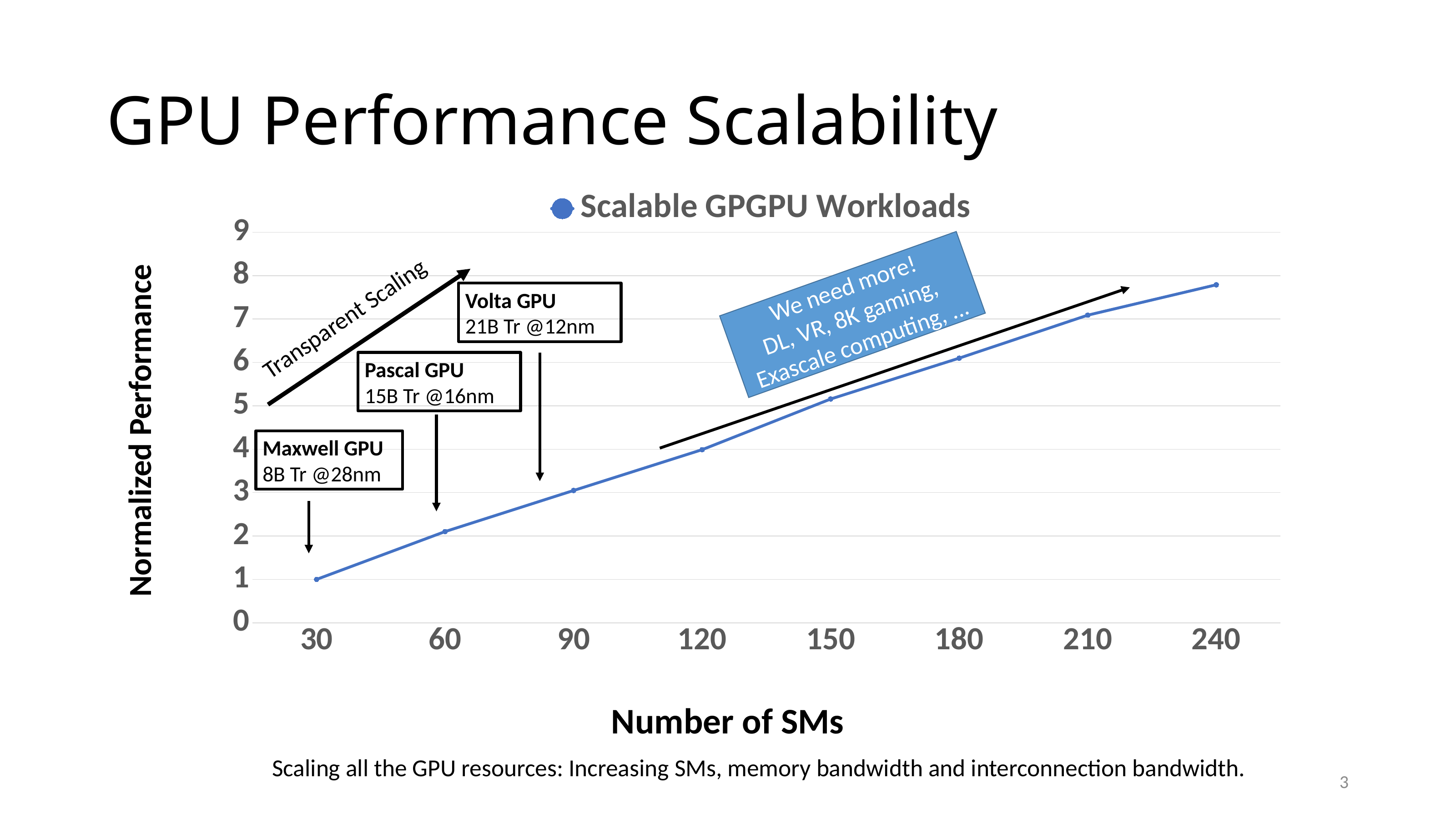
What is the normalized performance at 30 SMs? 1 Is the normalized performance at 150 SMs greater or less than 5? greater What is the name of the series shown in the legend? Scalable GPGPU Workloads How many series does the legend list? 1 How many data points are plotted on the line? 8 Is the normalized performance at 240 SMs greater or less than 8? less What kind of chart is shown on the slide? line chart Does normalized performance rise or fall as the number of SMs increases? rises At which number of SMs is the normalized performance highest? 240 At which number of SMs is the normalized performance lowest? 30